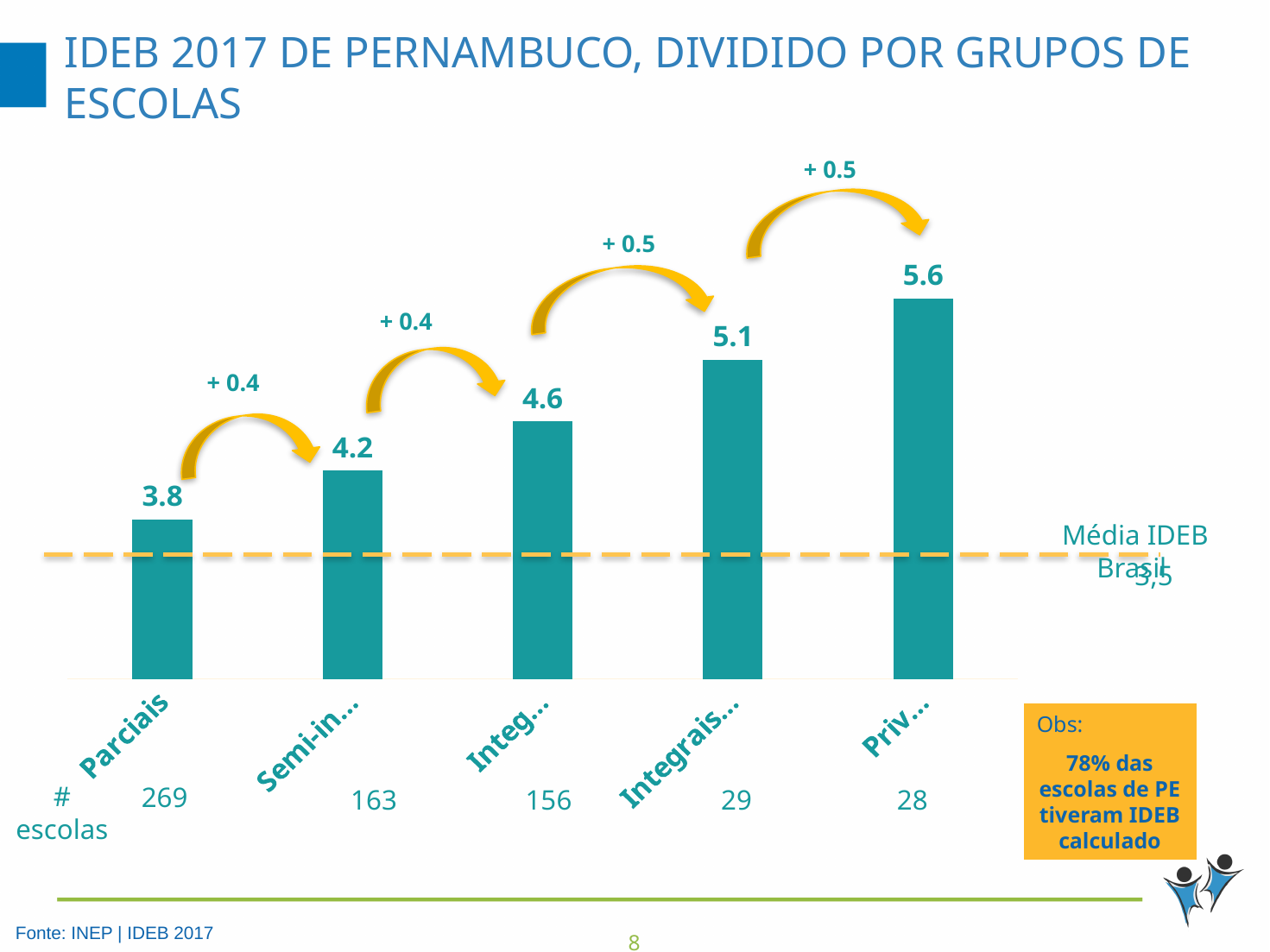
What is the value shown on the middle (third) bar of the chart? 4.6 What increase is shown by the arrow between the Parciais bar and the second bar? + 0.4 Do the IDEB values rise or fall from left to right across the bars? rise Which bar has the lowest IDEB value? Parciais What type of chart is shown on the slide? bar chart How many schools (# escolas) are listed under the Parciais group? 269 How many bars are plotted on the chart? 5 What is the IDEB 2017 value for the Parciais group? 3.8 What is the value shown on the rightmost bar of the chart? 5.6 What is the highest IDEB value shown on the chart? 5.6 Which is larger: the value of the second bar from the left or the value of the fourth bar from the left? the fourth bar (5.1) What is the difference between the rightmost bar (5.6) and the Parciais bar (3.8)? 1.8